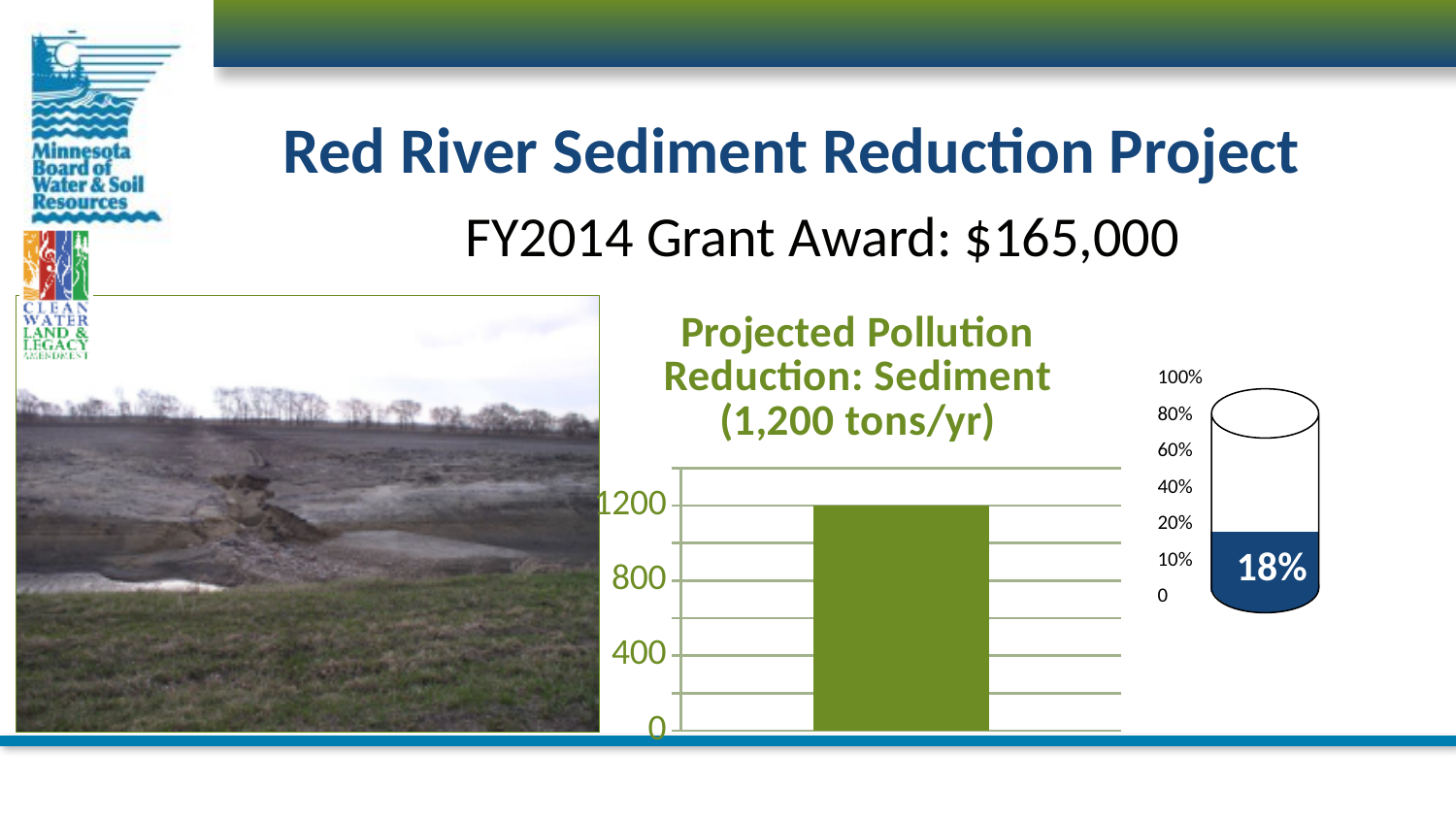
What colour is the bar in the chart titled "Projected Pollution Reduction: Sediment"? green In the bar chart titled "Projected Pollution Reduction: Sediment", is the value of the bar greater or less than 800? greater What percentage is shown in the cylinder gauge on the right side of the slide? 18% In the bar chart titled "Projected Pollution Reduction: Sediment", what value does the bar reach on the y axis? 1200 What kind of chart is the chart titled "Projected Pollution Reduction: Sediment"? bar chart How many bars are plotted in the bar chart titled "Projected Pollution Reduction: Sediment"? 1 In the cylinder gauge on the right side of the slide, is the filled value greater or less than 20%? less What is the title of the bar chart on the slide? Projected Pollution Reduction: Sediment (1,200 tons/yr) What is the highest percentage labelled on the scale of the cylinder gauge on the right side of the slide? 100% What is the highest value labelled on the y axis of the bar chart titled "Projected Pollution Reduction: Sediment"? 1200